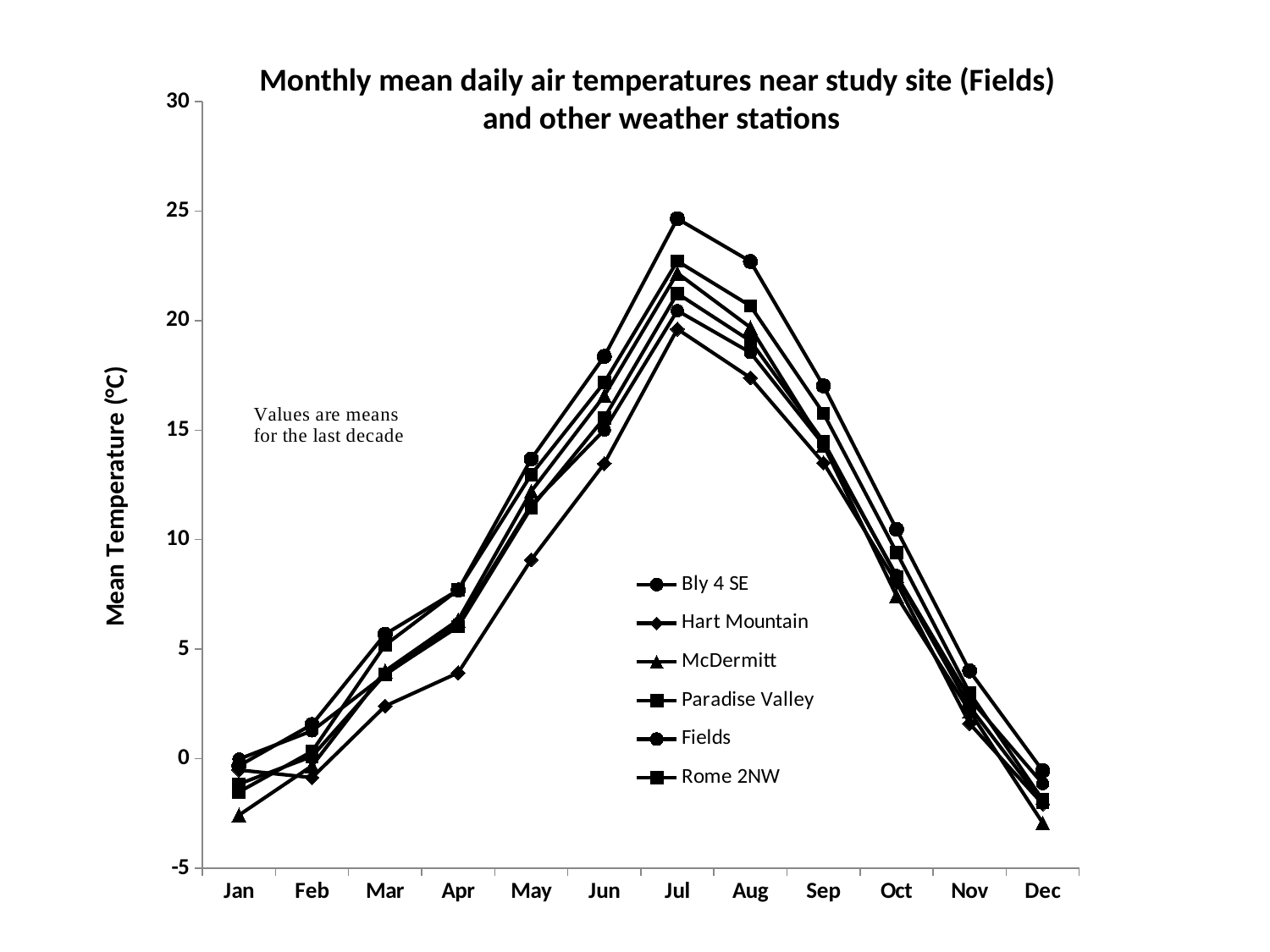
Which series has the lowest value in July? Hart Mountain Which series has the lowest value in January? McDermitt Is the value for McDermitt in January greater or less than 0? less Do the temperature values rise or fall from January to July? rise How many months are plotted along the x axis? 12 What is the title of the chart? Monthly mean daily air temperatures near study site (Fields) and other weather stations Is the value for Hart Mountain in May greater or less than 10? less How many series does the legend list? 6 In which month does the Hart Mountain series reach its highest value? Jul What is the label on the y axis? Mean Temperature (°C) Is the value for Hart Mountain in August greater or less than 20? less What kind of chart is shown on the slide? line chart